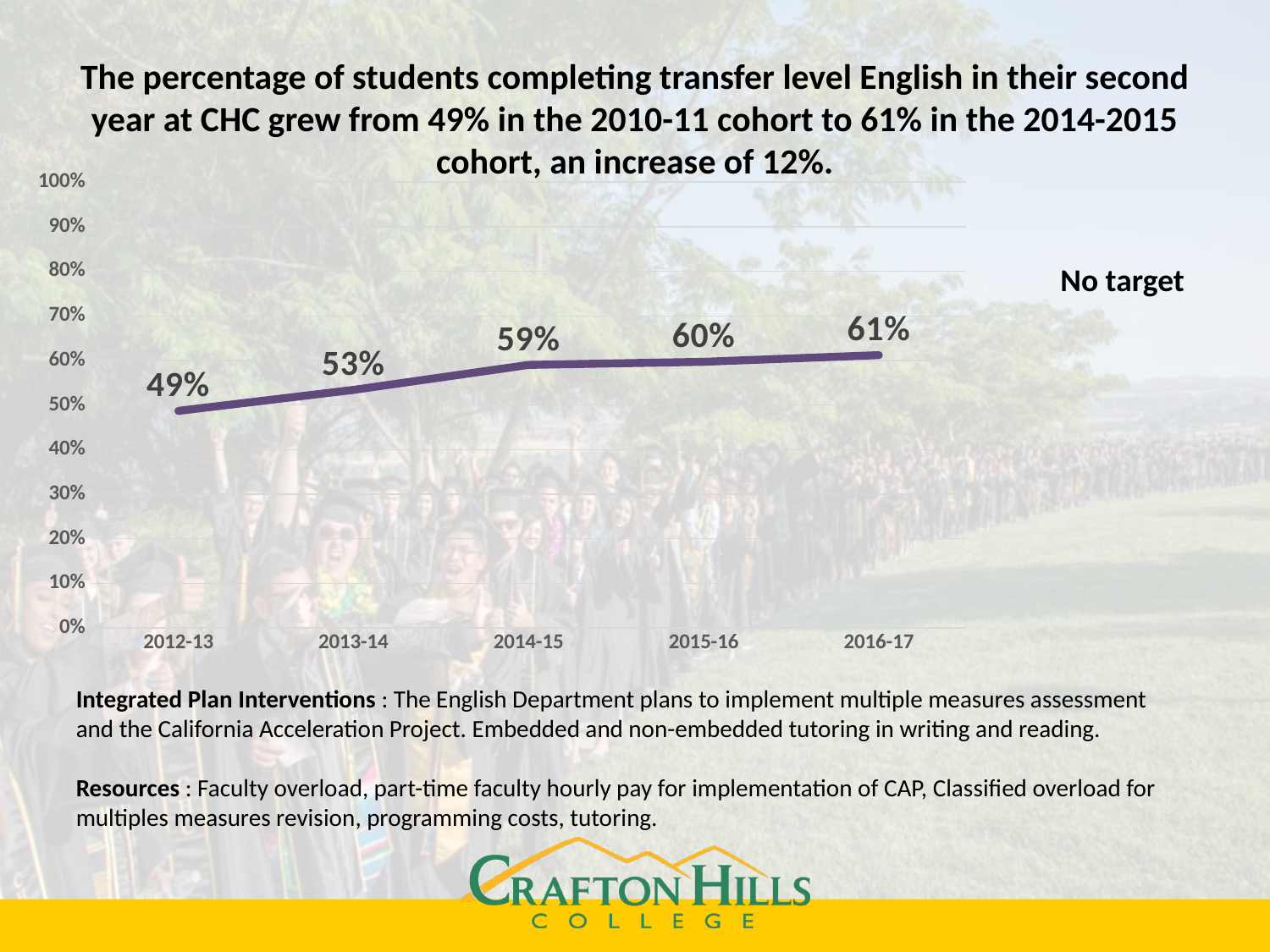
Do the values rise or fall from 2012-13 to 2016-17? rise Which year has the lowest value? 2012-13 How many years are plotted on the chart? 5 What is the difference between the values for 2016-17 and 2012-13? 12% What is the value for 2014-15? 59% What is the difference between the values for 2014-15 and 2013-14? 6% Which year has the highest value? 2016-17 What is the value for 2012-13? 49% What kind of chart is shown on the slide? line chart Which is larger, the value for 2013-14 or the value for 2015-16? 2015-16 What is the value for 2016-17? 61% Is the value for 2013-14 greater or less than 60%? less